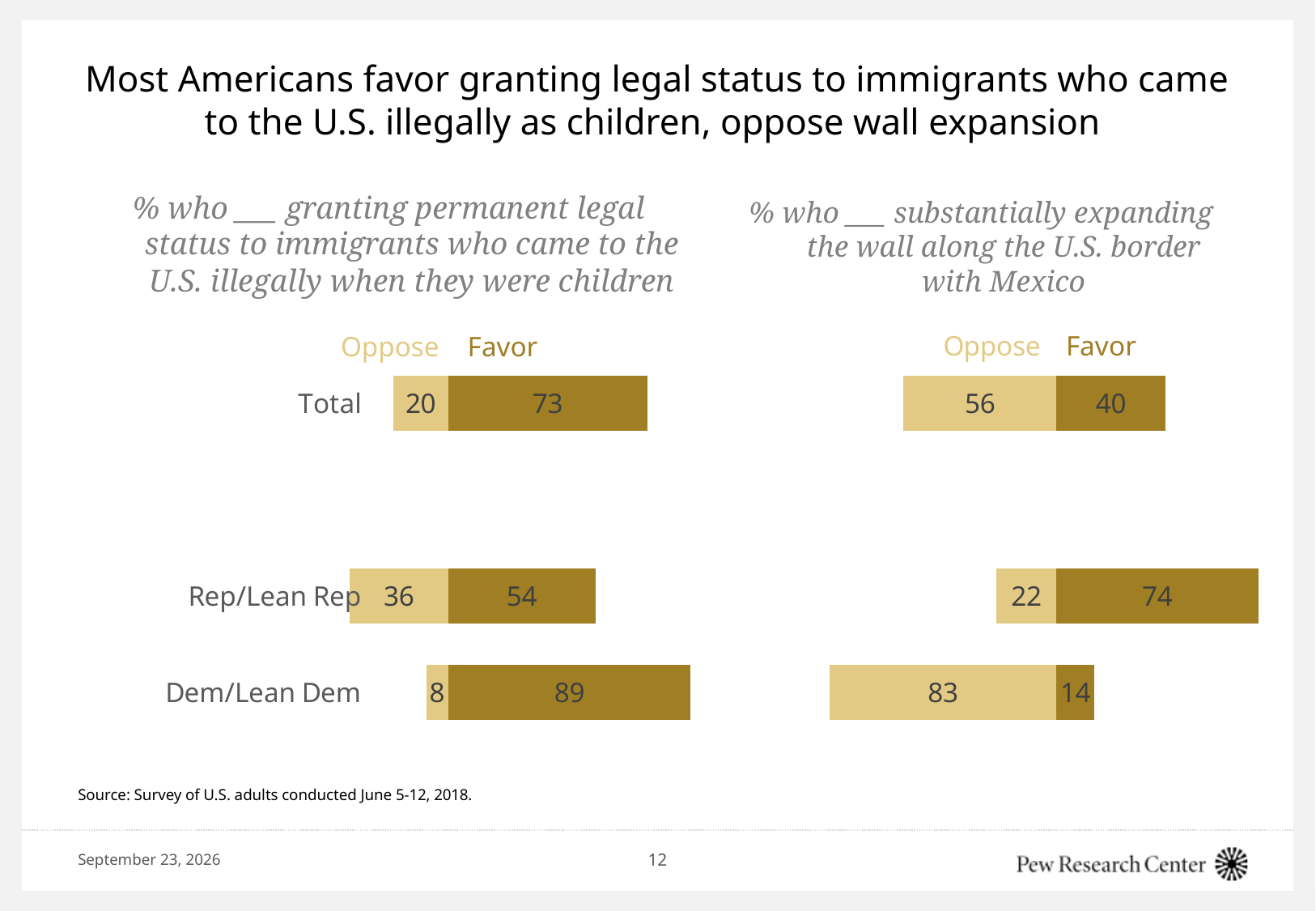
How many groups are shown in the left chart (granting permanent legal status)? 3 In the left chart (granting permanent legal status), is the Oppose value for Rep/Lean Rep larger or smaller than the Oppose value for Total? larger In the left chart (granting permanent legal status), what percentage of the Total favor it? 73 In the left chart (granting permanent legal status), what is the difference between the Favor values for Dem/Lean Dem and Rep/Lean Rep? 35 In the right chart (expanding the wall), what percentage of Dem/Lean Dem oppose it? 83 In the right chart (expanding the wall), what is the total of Oppose and Favor for the Total bar? 96 In the right chart (expanding the wall), what is the difference between the Oppose values for Dem/Lean Dem and Rep/Lean Rep? 61 In the right chart (expanding the wall), which group has the lowest Favor value? Dem/Lean Dem What type of chart is the left chart (granting permanent legal status)? bar chart In the right chart (expanding the wall), what percentage of Rep/Lean Rep favor it? 74 How many series does the legend of the right chart (expanding the wall) list? 2 In the left chart (granting permanent legal status), which group has the highest Favor value? Dem/Lean Dem